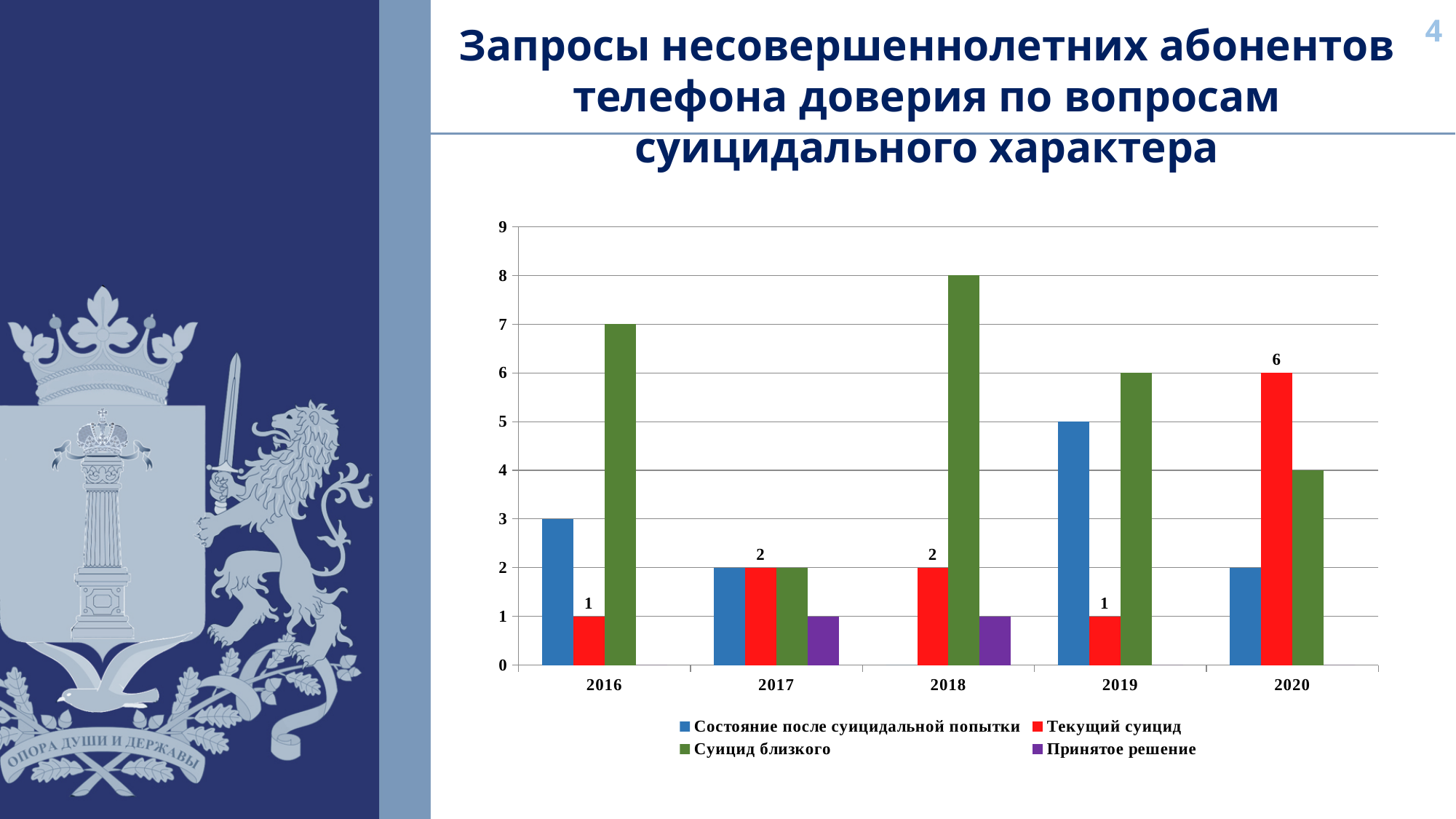
In which year is the value for Текущий суицид highest? 2020 What is the value for Текущий суицид in 2018? 2 What is the difference between the Текущий суицид values for 2020 and 2019? 5 What is the value for Текущий суицид in 2016? 1 Is the value for Суицид близкого in 2018 greater or less than 5? greater Which colour represents the series Принятое решение in the legend? Purple How many series does the legend list? 4 Which is larger in 2018: the value for Суицид близкого or the value for Текущий суицид? Суицид близкого Is the value for Состояние после суицидальной попытки in 2020 greater or less than 4? less What is the value for Текущий суицид in 2020? 6 What kind of chart is shown on the slide? Bar chart How many years are shown on the x axis? 5